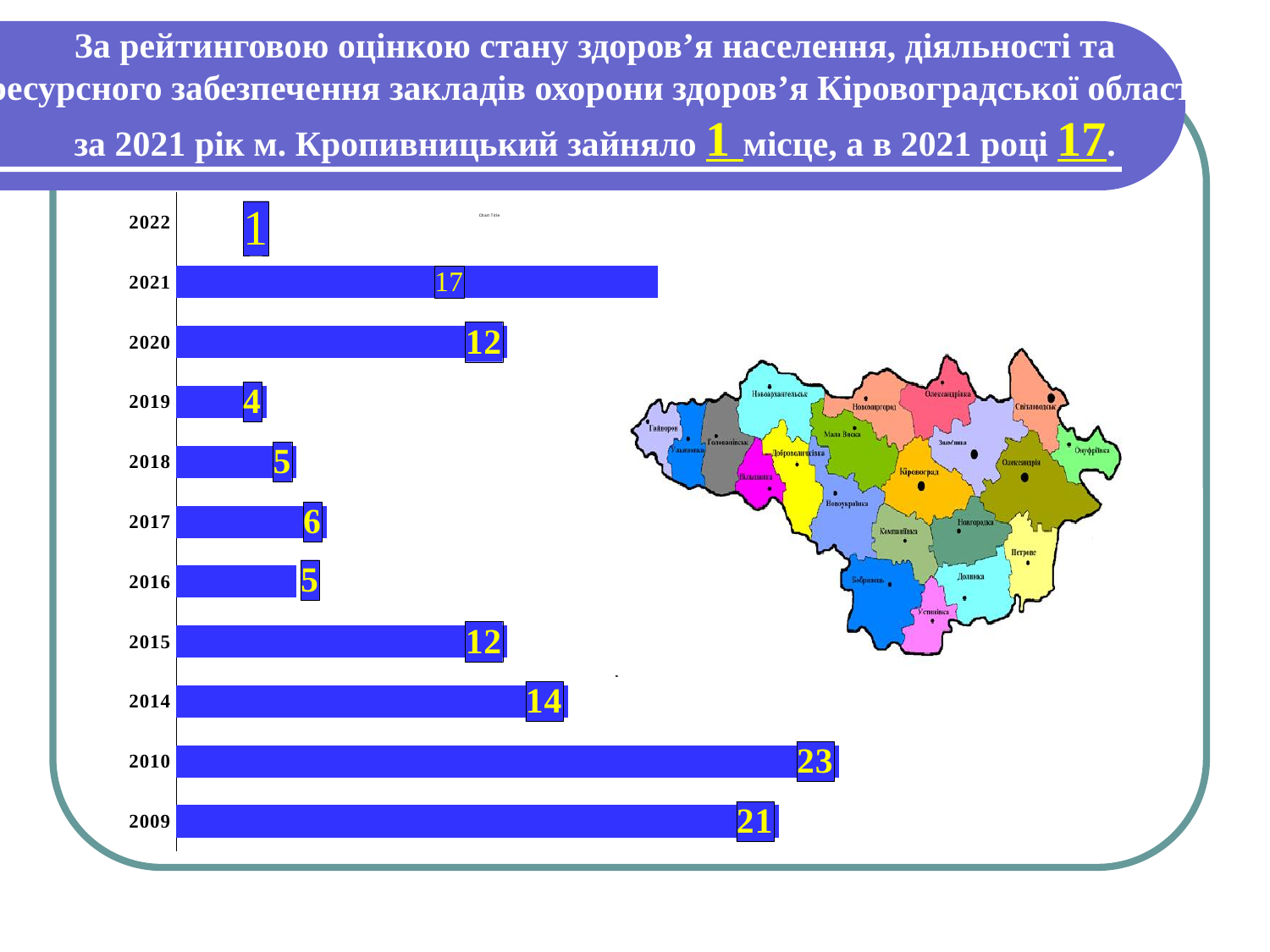
Which year has the lowest value? 2022 Which year has the highest value? 2010 How many years are shown on the chart? 11 What is the difference between the values for 2010 and 2009? 2 What is the value for 2010? 23 What is the value for 2021? 17 What kind of chart is shown on the slide? bar chart What is the value for 2019? 4 What is the difference between the values for 2021 and 2020? 5 What colour are the bars in the chart? blue Which is larger, the value for 2014 or the value for 2015? 2014 What is the value for 2022? 1